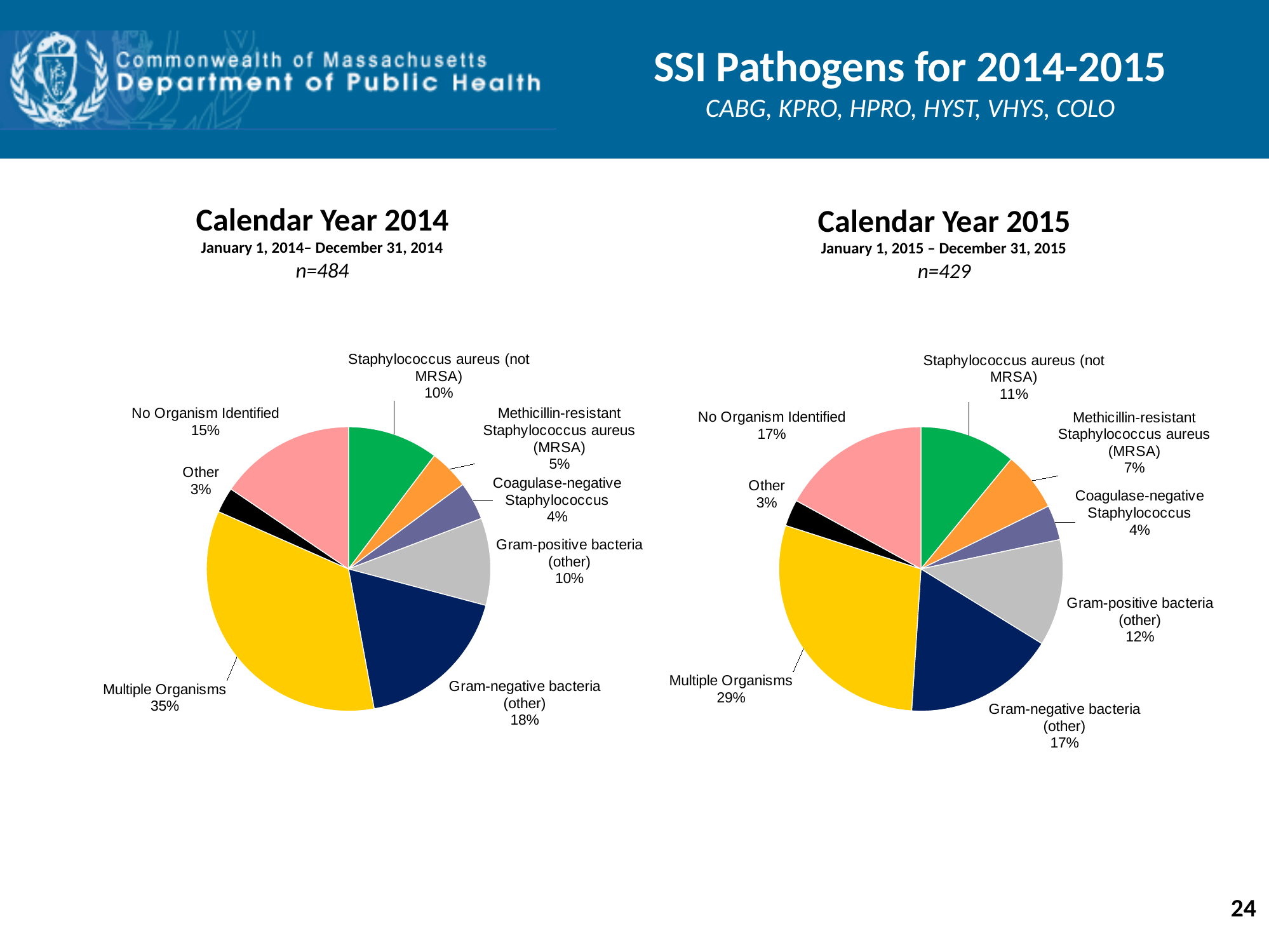
In the Calendar Year 2014 pie chart, what is the difference between the Gram-negative bacteria (other) share and the Gram-positive bacteria (other) share? 8% In the Calendar Year 2015 pie chart, what share is No Organism Identified? 17% In the Calendar Year 2015 pie chart, what share is Methicillin-resistant Staphylococcus aureus (MRSA)? 7% In the Calendar Year 2015 pie chart, which category has the smallest share? Other In the Calendar Year 2014 pie chart, which category has the largest share? Multiple Organisms In the Calendar Year 2014 pie chart, what share is Coagulase-negative Staphylococcus? 4% How many slices does the Calendar Year 2014 pie chart have? 8 In the Calendar Year 2015 pie chart, which is larger: Gram-positive bacteria (other) or Staphylococcus aureus (not MRSA)? Gram-positive bacteria (other) What kind of chart is used for Calendar Year 2015? Pie chart In the Calendar Year 2014 pie chart, what share is Multiple Organisms? 35% In the Calendar Year 2014 pie chart, what colour is the Multiple Organisms slice? Yellow What is the sample size (n) shown for the Calendar Year 2015 chart? n=429